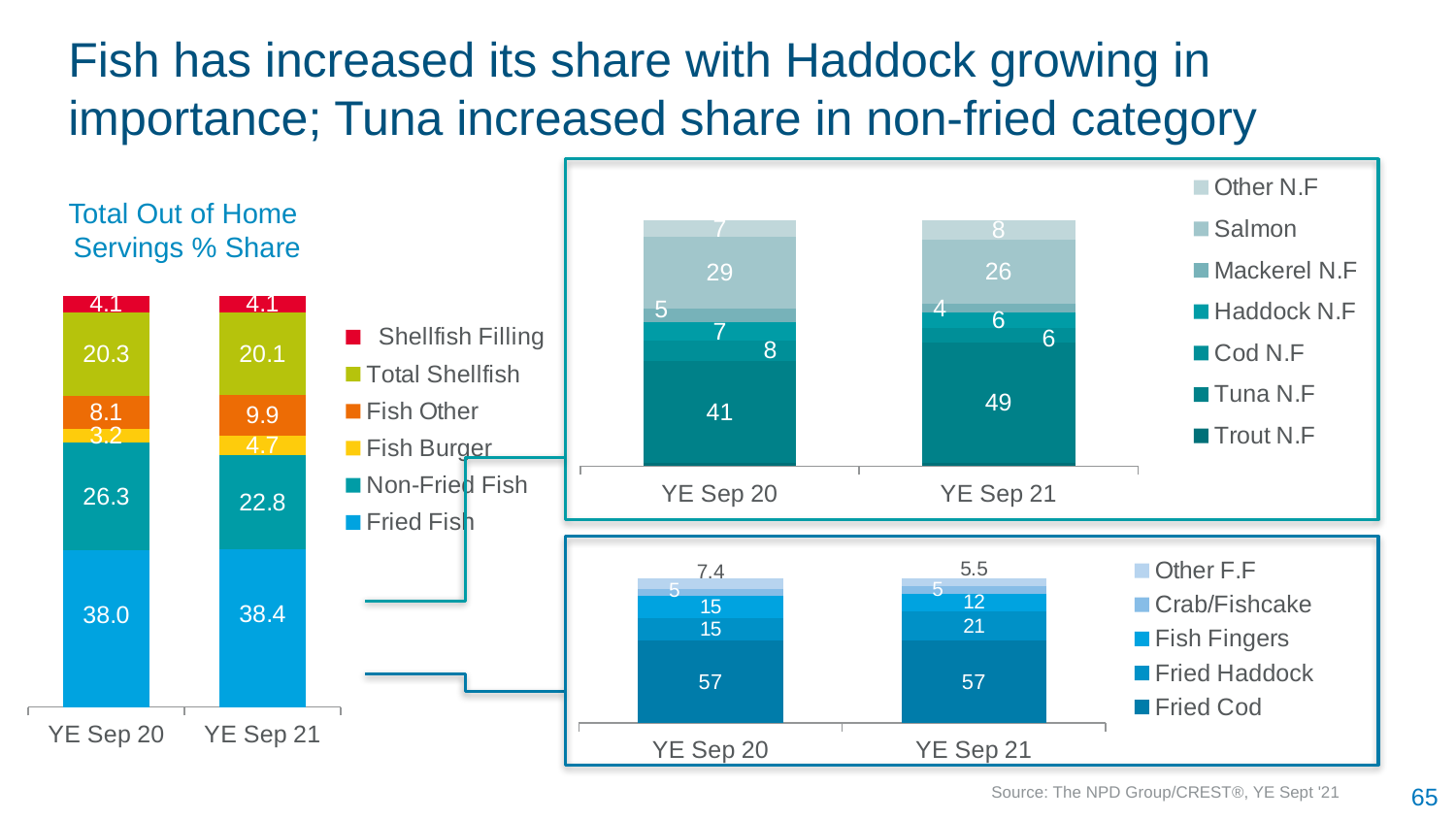
What kind of chart is the Total Out of Home Servings % Share chart? Stacked bar chart In the Total Out of Home Servings % Share chart, how many series does the legend list? 6 In the top-right non-fried fish chart, what is the value for Salmon in YE Sep 20? 29 In the bottom-right fried fish chart, is Fish Fingers larger in YE Sep 20 or YE Sep 21? YE Sep 20 In the bottom-right fried fish chart, what is the value for Fried Haddock in YE Sep 21? 21 In the Total Out of Home Servings % Share chart, which segment is the largest in YE Sep 20? Fried Fish In the bottom-right fried fish chart, what is the difference in Other F.F between YE Sep 20 and YE Sep 21? 1.9 In the Total Out of Home Servings % Share chart, what is the value for Fried Fish in YE Sep 21? 38.4 In the top-right non-fried fish chart, how many series does the legend list? 7 In the Total Out of Home Servings % Share chart, by how much did Fish Other change from YE Sep 20 to YE Sep 21? 1.8 In the Total Out of Home Servings % Share chart, what is the value for Non-Fried Fish in YE Sep 20? 26.3